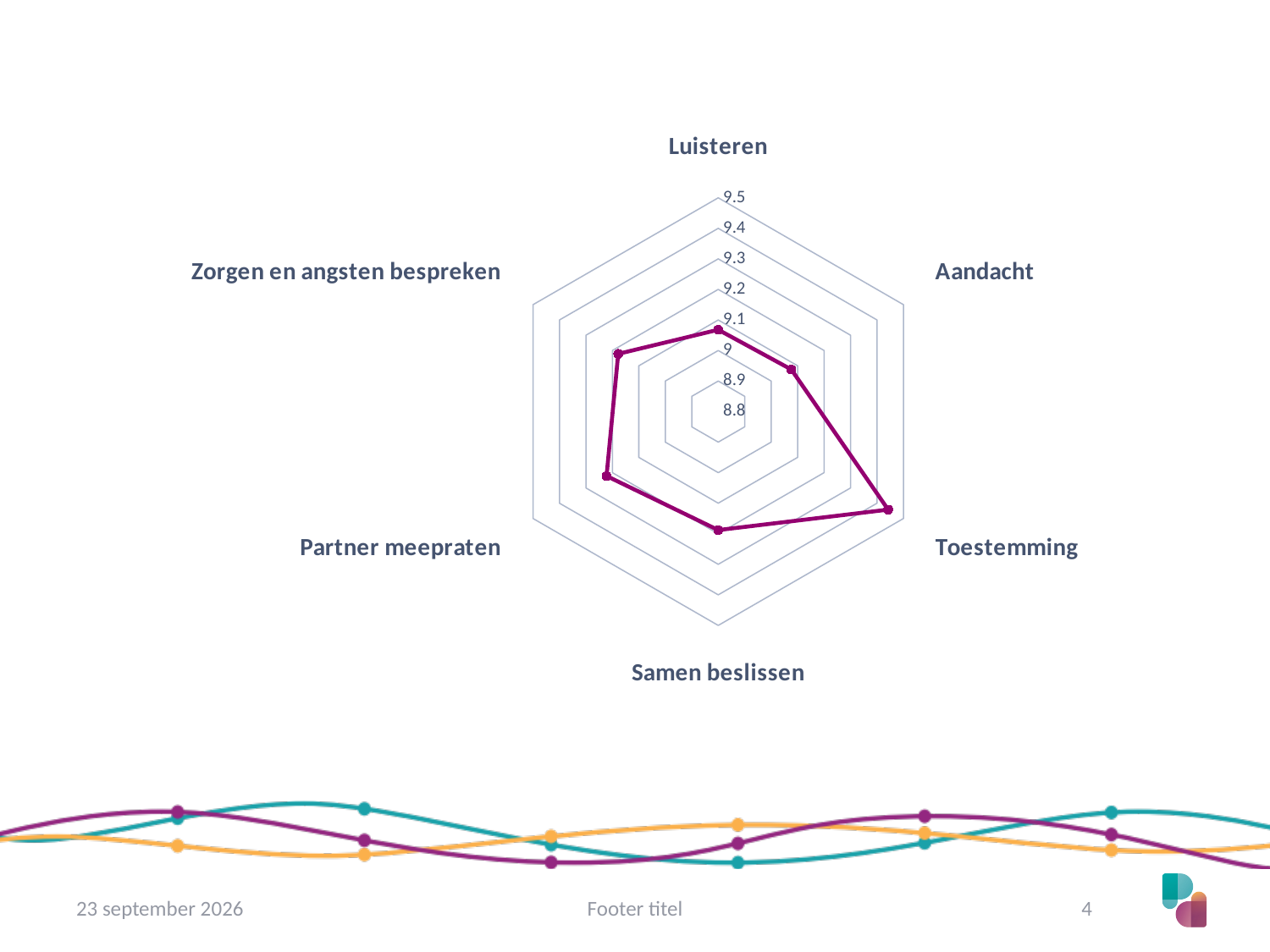
Is the value for Partner meepraten greater or less than 9.1? greater What is the highest value shown on the radar chart's axis scale? 9.5 Is the value for Aandacht greater or less than 9.2? less Which has the larger value, Toestemming or Luisteren? Toestemming Is the value for Luisteren greater or less than 9.2? less Which category label appears at the top of the radar chart? Luisteren How many categories (axes) does the radar chart have? 6 Which category has the highest value on the radar chart? Toestemming What kind of chart is shown on the slide? Radar chart Which has the larger value, Partner meepraten or Aandacht? Partner meepraten